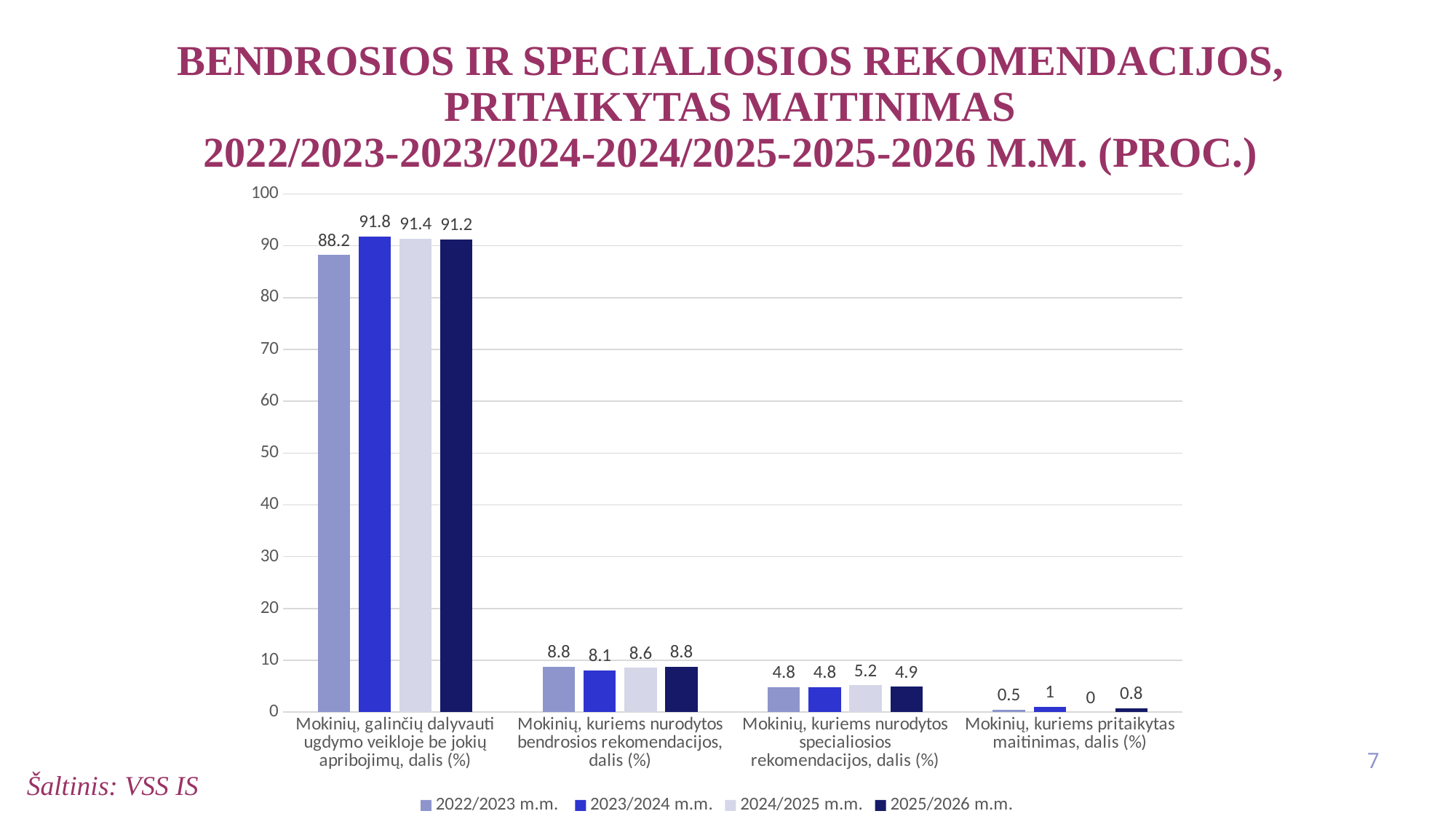
Is the value for 2025/2026 m.m. in the category "Mokinių, galinčių dalyvauti ugdymo veikloje be jokių apribojimų, dalis (%)" greater or less than 90? greater What is the value for 2023/2024 m.m. in the category "Mokinių, kuriems nurodytos bendrosios rekomendacijos, dalis (%)"? 8.1 What is the value for 2024/2025 m.m. in the category "Mokinių, kuriems nurodytos specialiosios rekomendacijos, dalis (%)"? 5.2 What is the value for 2023/2024 m.m. in the category "Mokinių, kuriems pritaikytas maitinimas, dalis (%)"? 1 Which school year has the lowest value in the category "Mokinių, kuriems pritaikytas maitinimas, dalis (%)"? 2024/2025 m.m. What is the difference between the 2023/2024 m.m. and 2022/2023 m.m. values in the category "Mokinių, galinčių dalyvauti ugdymo veikloje be jokių apribojimų, dalis (%)"? 3.6 What kind of chart is shown on the slide? Bar chart Which school year has the highest value in the category "Mokinių, galinčių dalyvauti ugdymo veikloje be jokių apribojimų, dalis (%)"? 2023/2024 m.m. In the category "Mokinių, kuriems nurodytos bendrosios rekomendacijos, dalis (%)", which is larger: the value for 2023/2024 m.m. or for 2024/2025 m.m.? 2024/2025 m.m. How many categories are shown on the x axis of the chart? 4 What is the value for 2022/2023 m.m. in the category "Mokinių, galinčių dalyvauti ugdymo veikloje be jokių apribojimų, dalis (%)"? 88.2 How many series does the legend list? 4